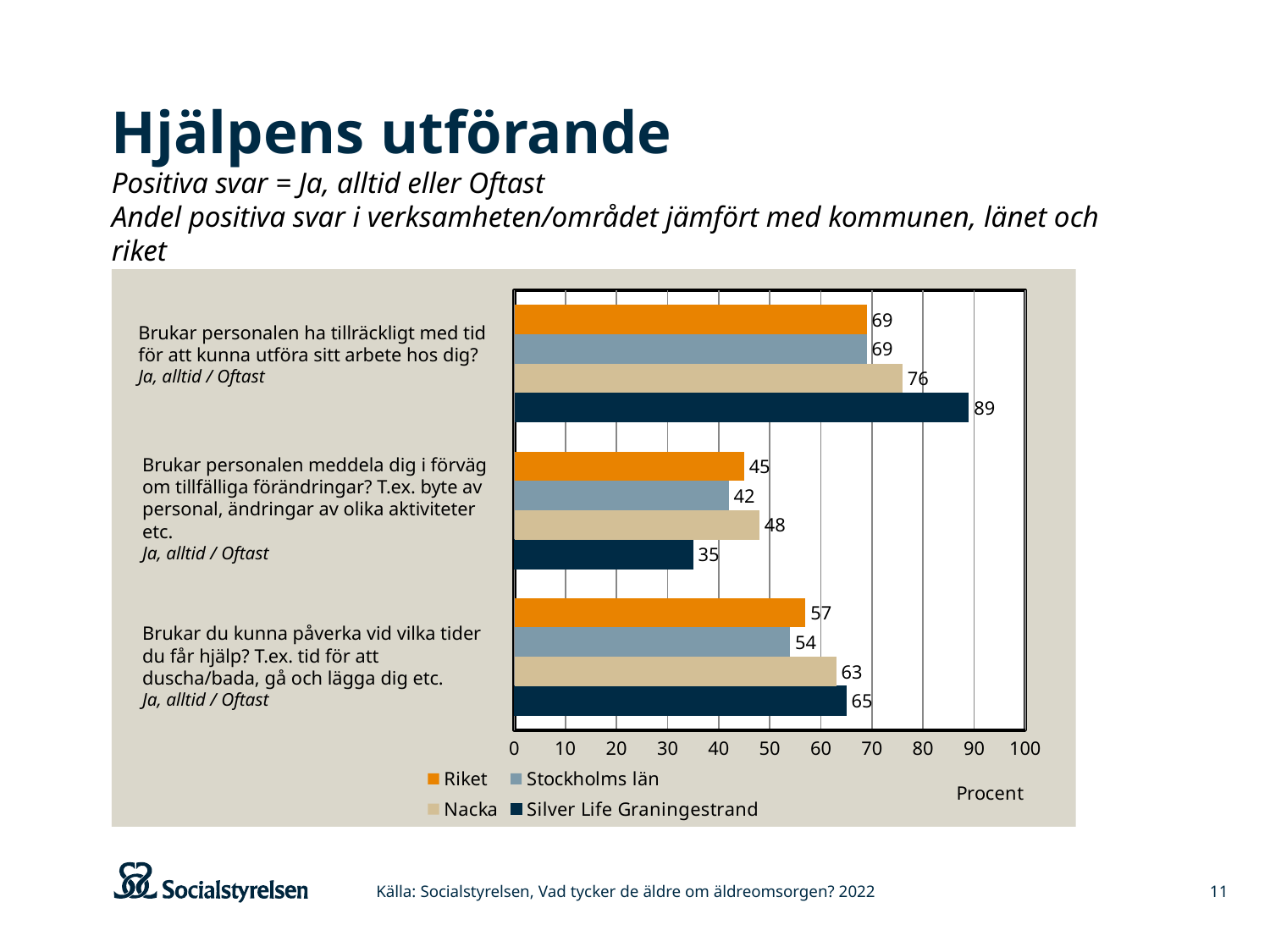
What unit is shown on the horizontal axis of the chart? Procent On the question "Brukar personalen meddela dig i förväg om tillfälliga förändringar?", which is larger: Riket or Stockholms län? Riket What is the value for Stockholms län on the question "Brukar du kunna påverka vid vilka tider du får hjälp?"? 54 Which series has the highest value on the question "Brukar personalen ha tillräckligt med tid för att kunna utföra sitt arbete hos dig?"? Silver Life Graningestrand How many series does the legend list? 4 What kind of chart is shown on the slide? Bar chart Which series has the lowest value on the question "Brukar personalen meddela dig i förväg om tillfälliga förändringar?"? Silver Life Graningestrand What is the value for Nacka on the question "Brukar personalen meddela dig i förväg om tillfälliga förändringar?"? 48 What is the difference between Nacka and Stockholms län on the question "Brukar du kunna påverka vid vilka tider du får hjälp?"? 9 What is the value for Silver Life Graningestrand on the question "Brukar personalen ha tillräckligt med tid för att kunna utföra sitt arbete hos dig?"? 89 What is the difference between Silver Life Graningestrand and Riket on the question "Brukar personalen ha tillräckligt med tid för att kunna utföra sitt arbete hos dig?"? 20 How many questions (categories) are shown on the chart? 3